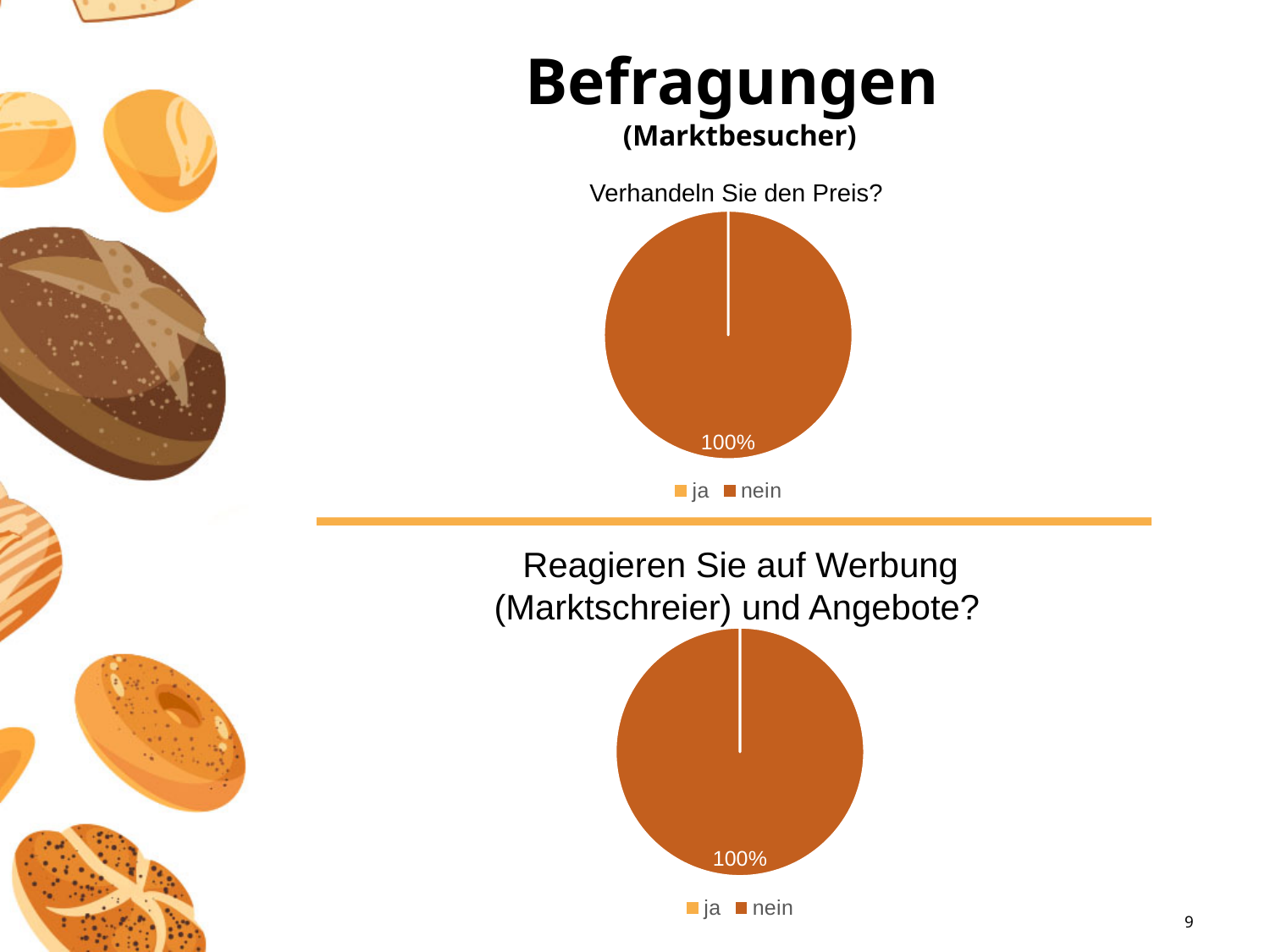
In the chart titled "Verhandeln Sie den Preis?", which is larger, the share for "ja" or the share for "nein"? nein In the lower chart, which is larger, the share for "ja" or the share for "nein"? nein In the chart titled "Reagieren Sie auf Werbung (Marktschreier) und Angebote?", which category has the largest share? nein In the chart titled "Reagieren Sie auf Werbung (Marktschreier) und Angebote?", what share of the pie is labelled "nein"? 100% How many entries does the legend of the chart titled "Reagieren Sie auf Werbung (Marktschreier) und Angebote?" list? 2 What is the title of the upper chart on the slide? Verhandeln Sie den Preis? What kind of chart is the chart titled "Verhandeln Sie den Preis?"? pie chart What are the two legend entries of the upper chart? ja, nein What kind of chart is the lower chart on the slide? pie chart In the chart titled "Verhandeln Sie den Preis?", what share of the pie is labelled "nein"? 100% How many entries does the legend of the chart titled "Verhandeln Sie den Preis?" list? 2 In the chart titled "Verhandeln Sie den Preis?", which category has the largest share? nein